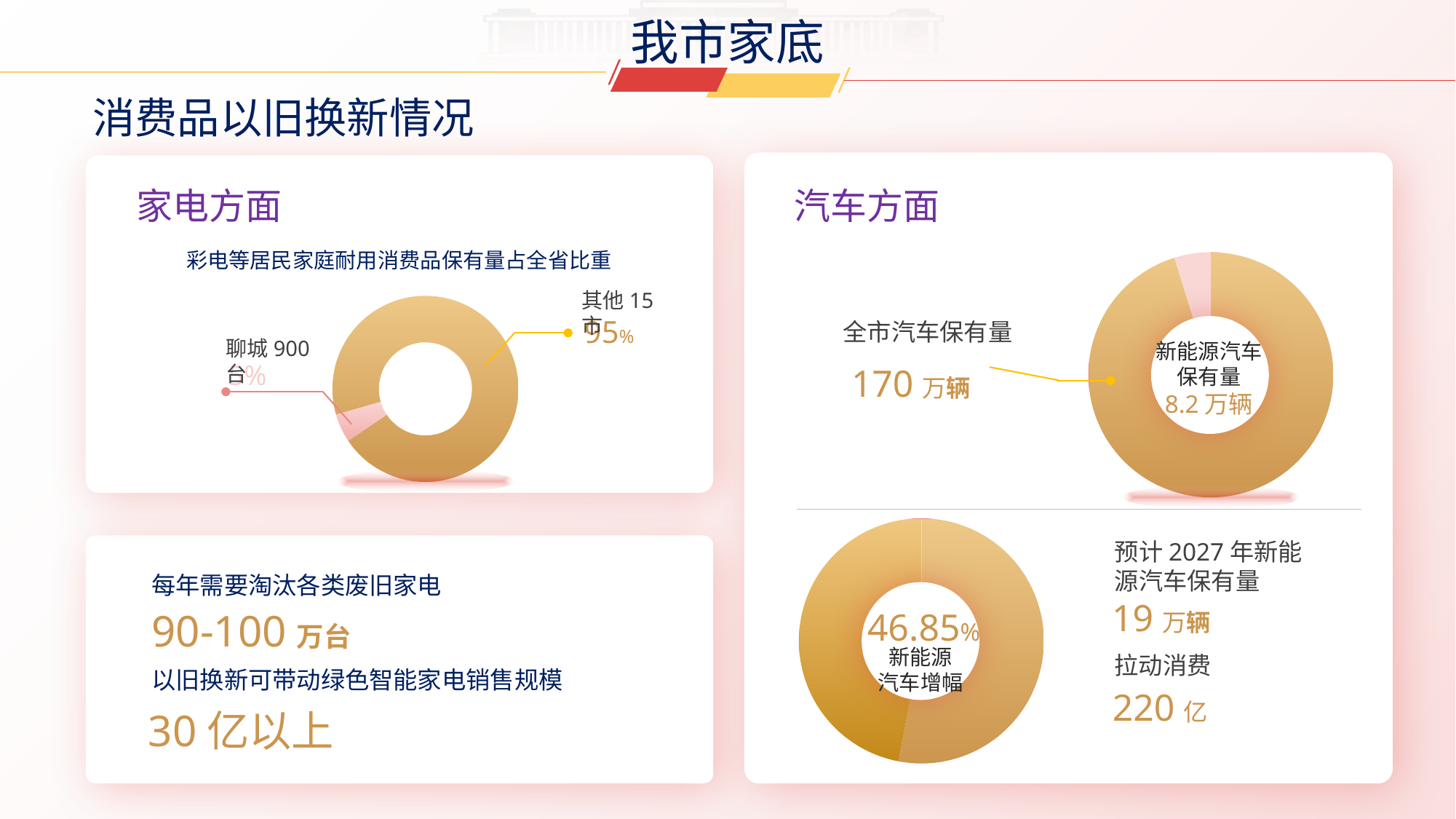
In the upper-right donut chart under 汽车方面, which slice is the smaller one? 新能源汽车保有量 In the upper-right donut chart under 汽车方面, what is the value of 新能源汽车保有量? 8.2 万辆 In the left chart 彩电等居民家庭耐用消费品保有量占全省比重, how many slices does the donut have? 2 What kind of chart is used for 彩电等居民家庭耐用消费品保有量占全省比重 on the left? Donut (pie) chart In the left chart 彩电等居民家庭耐用消费品保有量占全省比重, which slice is the smallest? 聊城 In the lower-right donut chart under 汽车方面, is the value for 新能源汽车增幅 greater or less than 50%? less In the lower-right donut chart under 汽车方面, what percentage is shown for 新能源汽车增幅? 46.85% In the upper-right donut chart under 汽车方面, what is the value of 全市汽车保有量? 170 万辆 In the left chart 彩电等居民家庭耐用消费品保有量占全省比重, what share is shown for 其他 15 市? 95% In the left chart 彩电等居民家庭耐用消费品保有量占全省比重, which slice is the largest? 其他 15 市 How many donut charts are shown on the slide? 3 In the upper-right donut chart under 汽车方面, which is larger: 全市汽车保有量 or 新能源汽车保有量? 全市汽车保有量